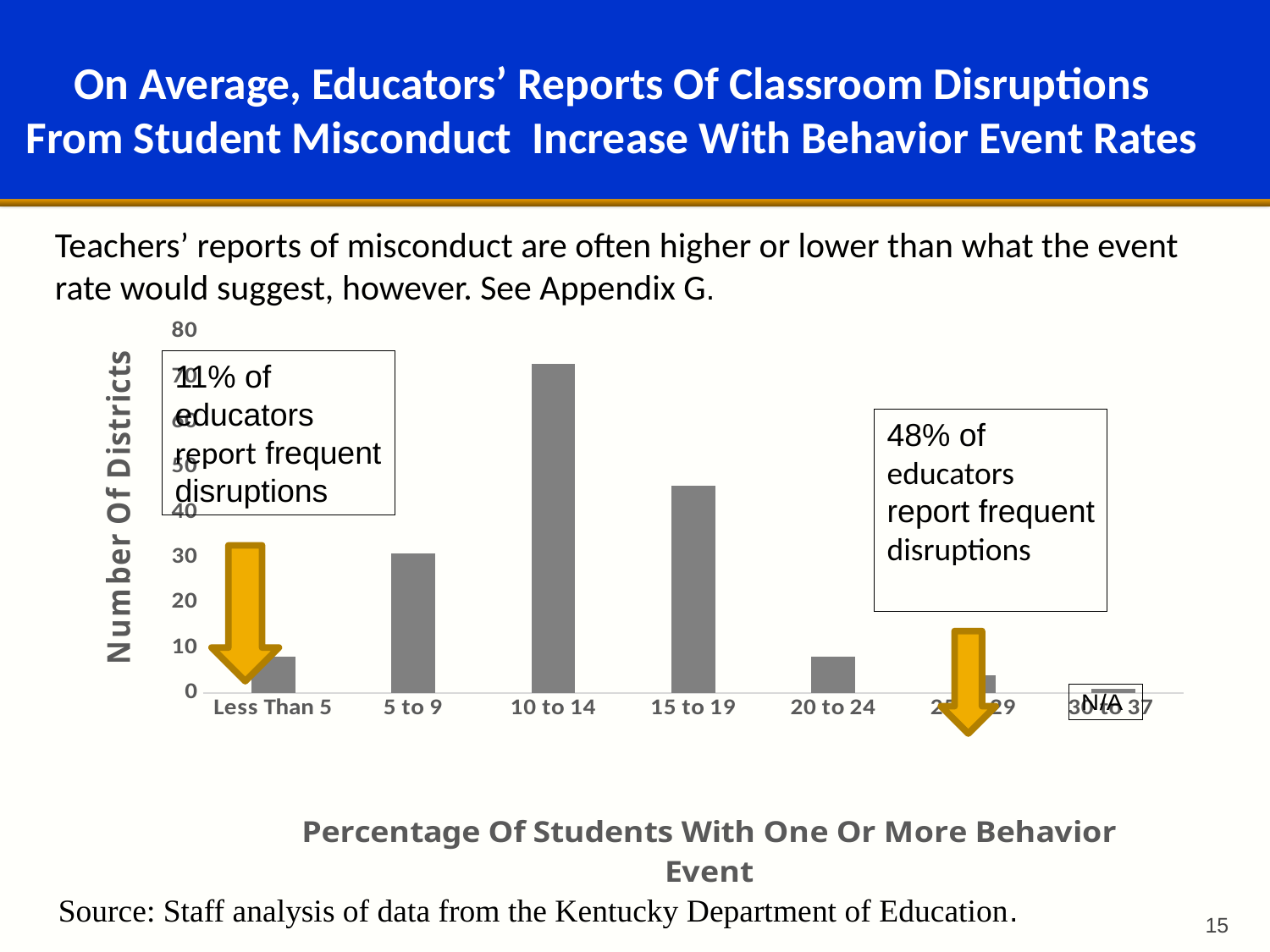
Is the number of districts for Less Than 5 greater or less than 10? less Is the number of districts for 10 to 14 greater or less than 60? greater What is the title of the x axis? Percentage Of Students With One Or More Behavior Event Is the number of districts for 5 to 9 greater or less than 40? less Which category has the highest number of districts? 10 to 14 Which has more districts, 10 to 14 or 15 to 19? 10 to 14 How many categories are shown on the x axis? 7 What is the title of the y axis? Number Of Districts Which category has the lowest number of districts? 30 to 37 What kind of chart is shown on the slide? bar chart